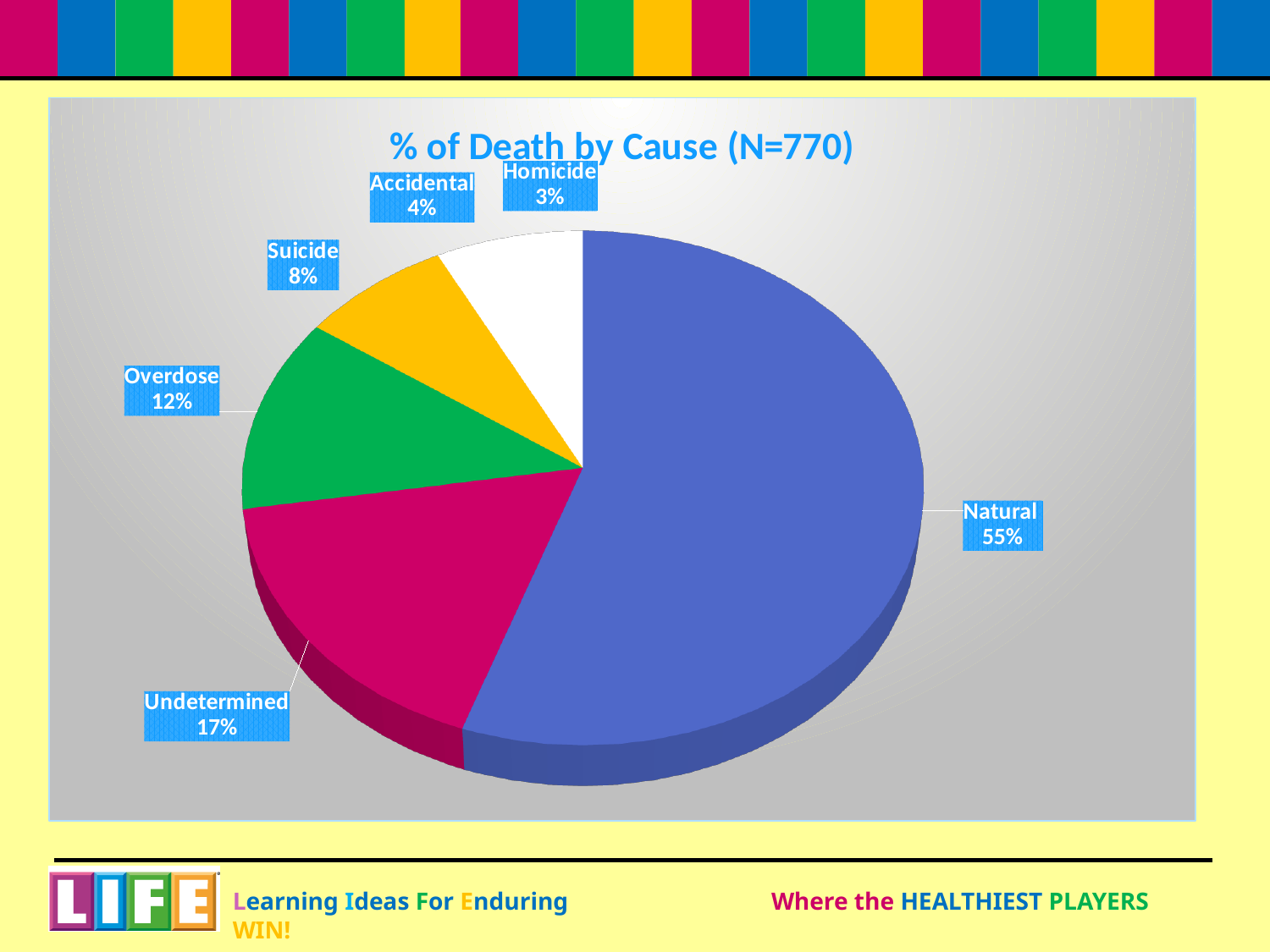
What is the difference in percentage points between Undetermined and Overdose? 5 What percentage of deaths is attributed to Overdose? 12% What percentage of deaths is attributed to Undetermined causes? 17% What colour is the Natural slice of the pie? blue What kind of chart is shown on the slide? pie chart How many categories (slices) are shown in the pie chart? 6 What is the title of the chart? % of Death by Cause (N=770) What percentage of deaths is attributed to Natural causes? 55% Which cause of death has the largest share of the pie? Natural Which is larger, the share for Suicide or the share for Accidental? Suicide What percentage of deaths is attributed to Homicide? 3% Which cause of death has the smallest share of the pie? Homicide